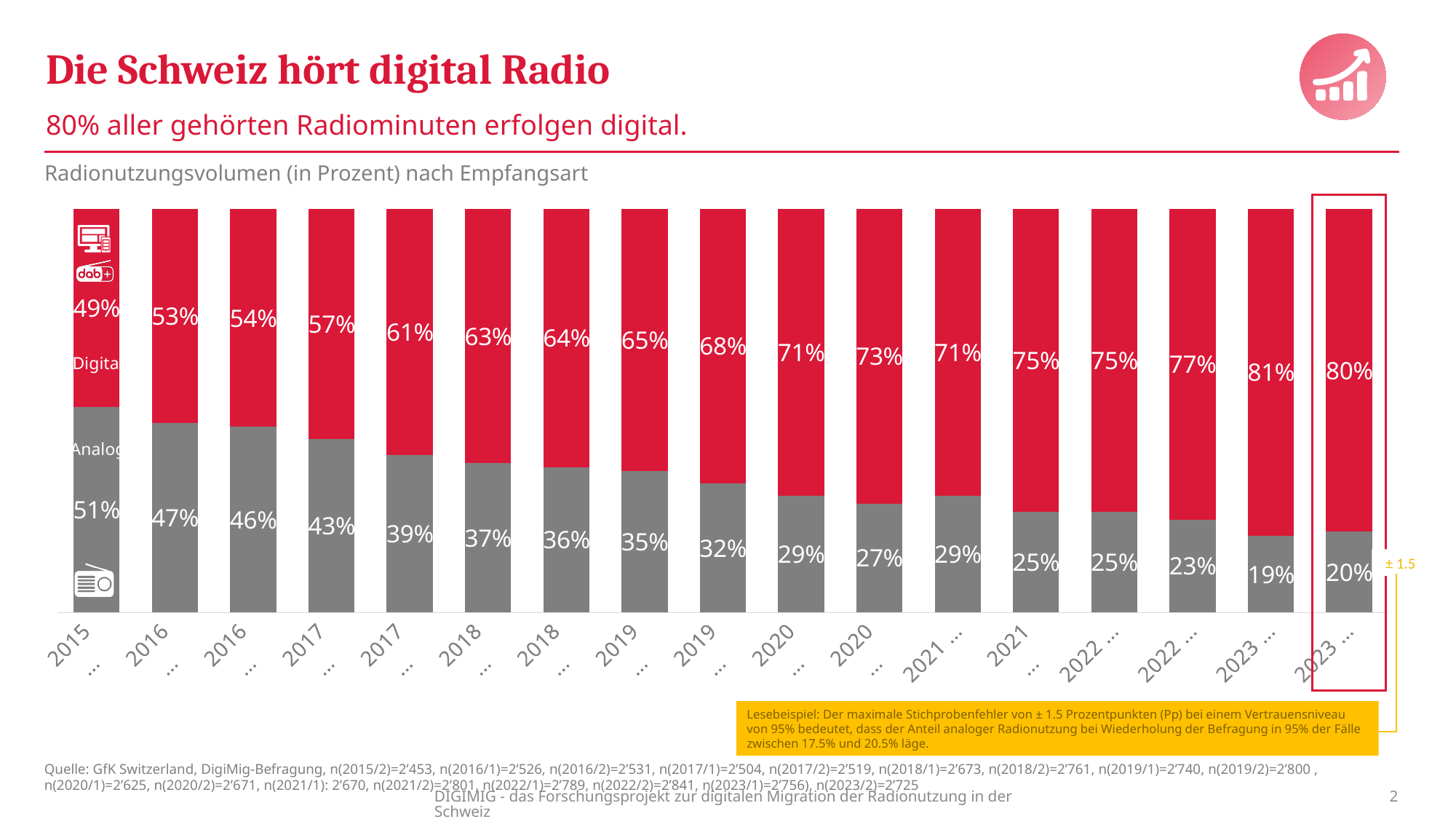
What is the lowest analog share shown in any bar? 19% What is the analog share (grey segment) in the rightmost, highlighted bar? 20% What kind of chart is shown on the slide? stacked bar chart What is the highest digital share shown in any bar? 81% How many bars are plotted in the chart? 17 Does the digital share generally rise or fall from left to right across the bars? rise What is the total of the two segments in the first bar (2015)? 100% What is the digital share in the second bar labelled 2020? 73% In the rightmost bar, what is the difference between the digital share and the analog share? 60 percentage points What is the digital share (red segment) in the first bar, labelled 2015? 49% In the first bar (2015), which is larger: the analog share or the digital share? Analog What is the title of the chart? Radionutzungsvolumen (in Prozent) nach Empfangsart